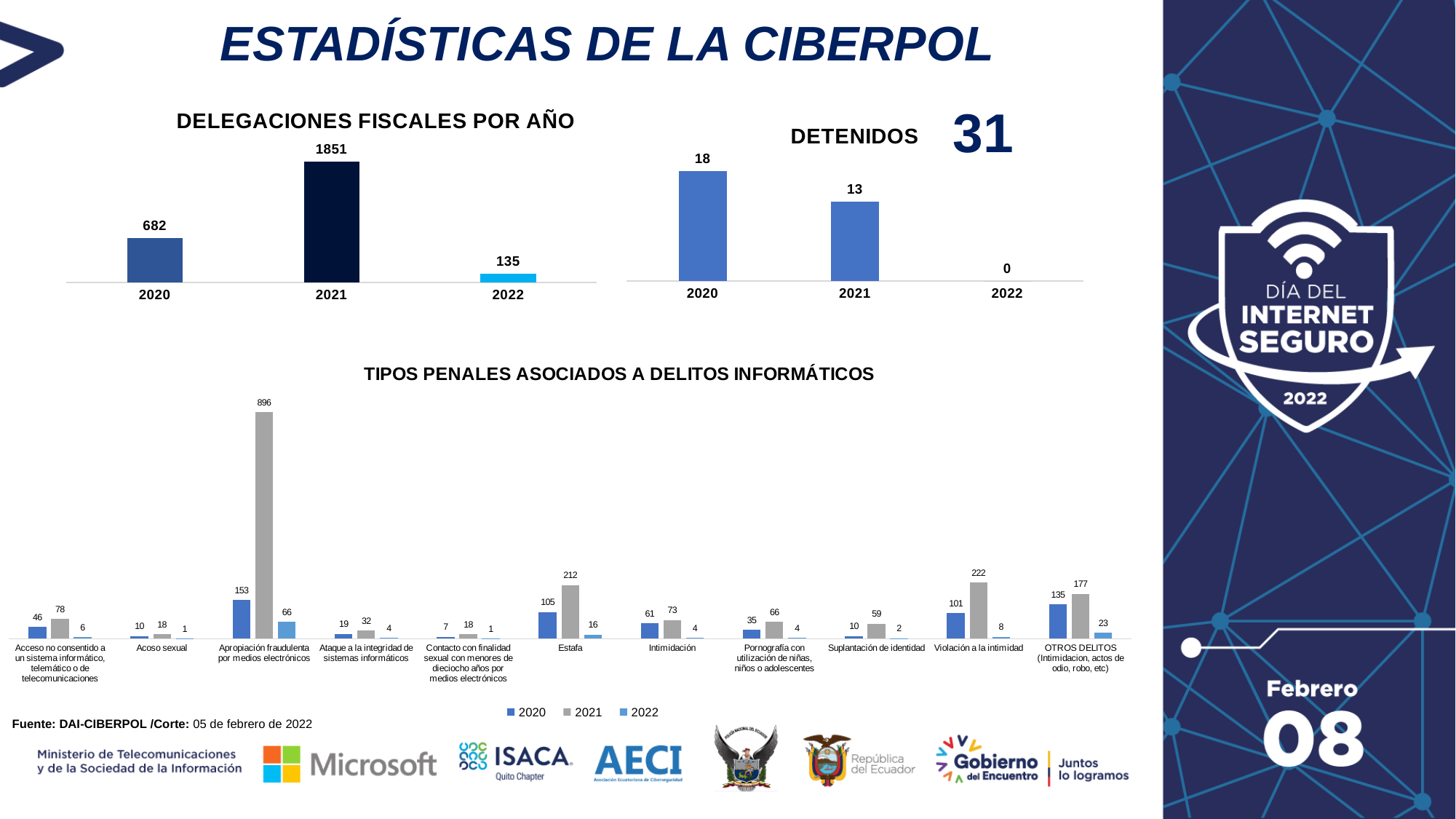
In the 'TIPOS PENALES ASOCIADOS A DELITOS INFORMÁTICOS' chart, what is the 2020 value for 'Estafa'? 105 In the 'DELEGACIONES FISCALES POR AÑO' chart, what is the difference between the 2021 and 2020 values? 1169 In the 'DELEGACIONES FISCALES POR AÑO' chart, which year has the lowest value? 2022 What kind of chart is 'TIPOS PENALES ASOCIADOS A DELITOS INFORMÁTICOS'? Bar chart In the 'TIPOS PENALES ASOCIADOS A DELITOS INFORMÁTICOS' chart, how many series does the legend list? 3 In the 'TIPOS PENALES ASOCIADOS A DELITOS INFORMÁTICOS' chart, how many categories are shown on the x axis? 11 In the 'DETENIDOS' chart, what is the value for 2020? 18 In the 'DETENIDOS' chart, which year has the highest value? 2020 In the 'TIPOS PENALES ASOCIADOS A DELITOS INFORMÁTICOS' chart, what is the 2021 value for 'Apropiación fraudulenta por medios electrónicos'? 896 In the 'DETENIDOS' chart, what is the value for 2022? 0 In the 'DELEGACIONES FISCALES POR AÑO' chart, what is the value for 2021? 1851 In the 'TIPOS PENALES ASOCIADOS A DELITOS INFORMÁTICOS' chart, which is larger for 2021: 'Violación a la intimidad' or 'Estafa'? Violación a la intimidad